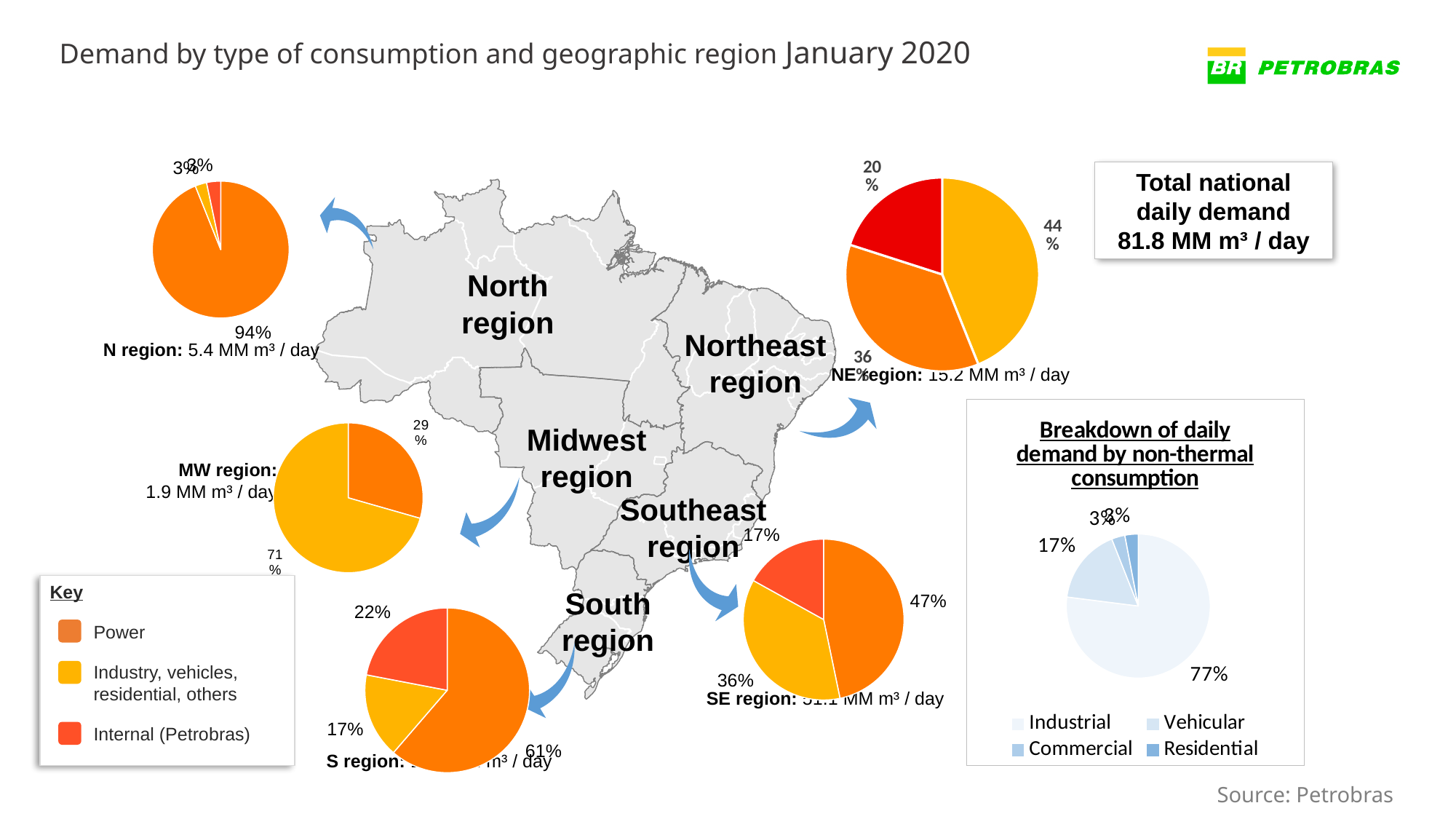
In the Midwest region pie chart, what share is Industry, vehicles, residential, others? 71% In the Northeast region pie chart, what is the difference between the Industry, vehicles, residential, others share and the Power share? 8% In the Southeast region pie chart, what share is Power? 47% In the Northeast region pie chart, what share is Industry, vehicles, residential, others? 44% In the 'Breakdown of daily demand by non-thermal consumption' pie chart, what share is Industrial? 77% In the Northeast region pie chart, what share is Internal (Petrobras)? 20% What type of chart is used to show the Midwest region's demand by type of consumption? Pie chart In the Southeast region pie chart, which category has the largest share? Power In the South region pie chart, which is larger: the Internal (Petrobras) share or the Industry, vehicles, residential, others share? Internal (Petrobras) In the South region pie chart, what share is Internal (Petrobras)? 22% In the North region pie chart, what share is Power? 94% How many categories does the legend of the 'Breakdown of daily demand by non-thermal consumption' chart list? 4